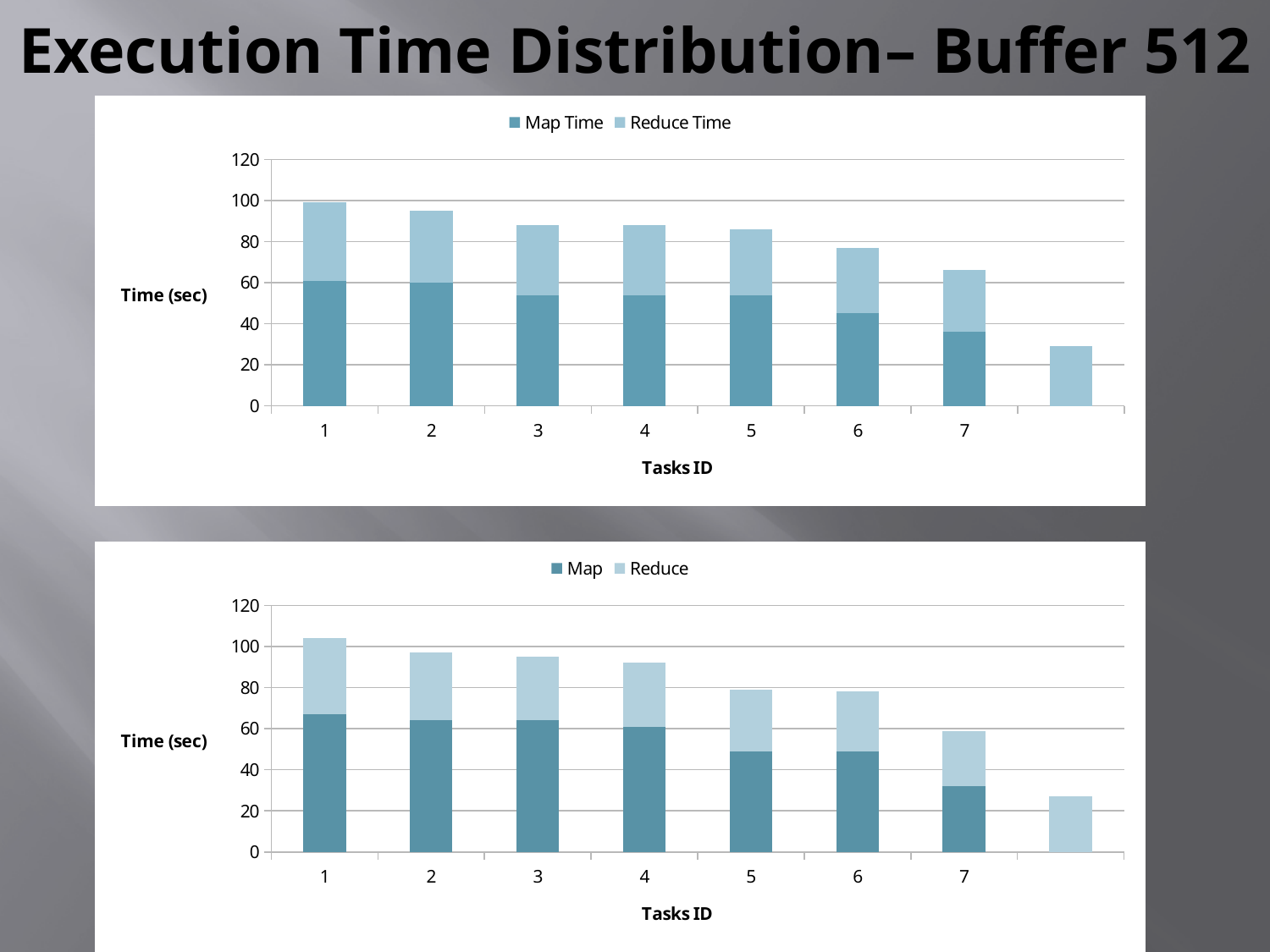
In the top chart, is the Map Time value for task 7 greater or less than 40? less In the bottom chart, which is larger: the Map value for task 1 or the Map value for task 7? task 1 In the top chart, do the total bar heights rise or fall as the task ID increases from 1 to 7? fall In the bottom chart, is the Map value for task 7 greater or less than 40? less In the bottom chart, which labeled task ID has the shortest stacked bar? 7 How many series does the legend of the top chart list? 2 What type of chart is the top chart on the slide? stacked bar chart In the bottom chart, is the total bar height for task 1 greater or less than 100? greater In the top chart, which task ID has the tallest stacked bar? 1 What are the two series named in the legend of the bottom chart? Map and Reduce